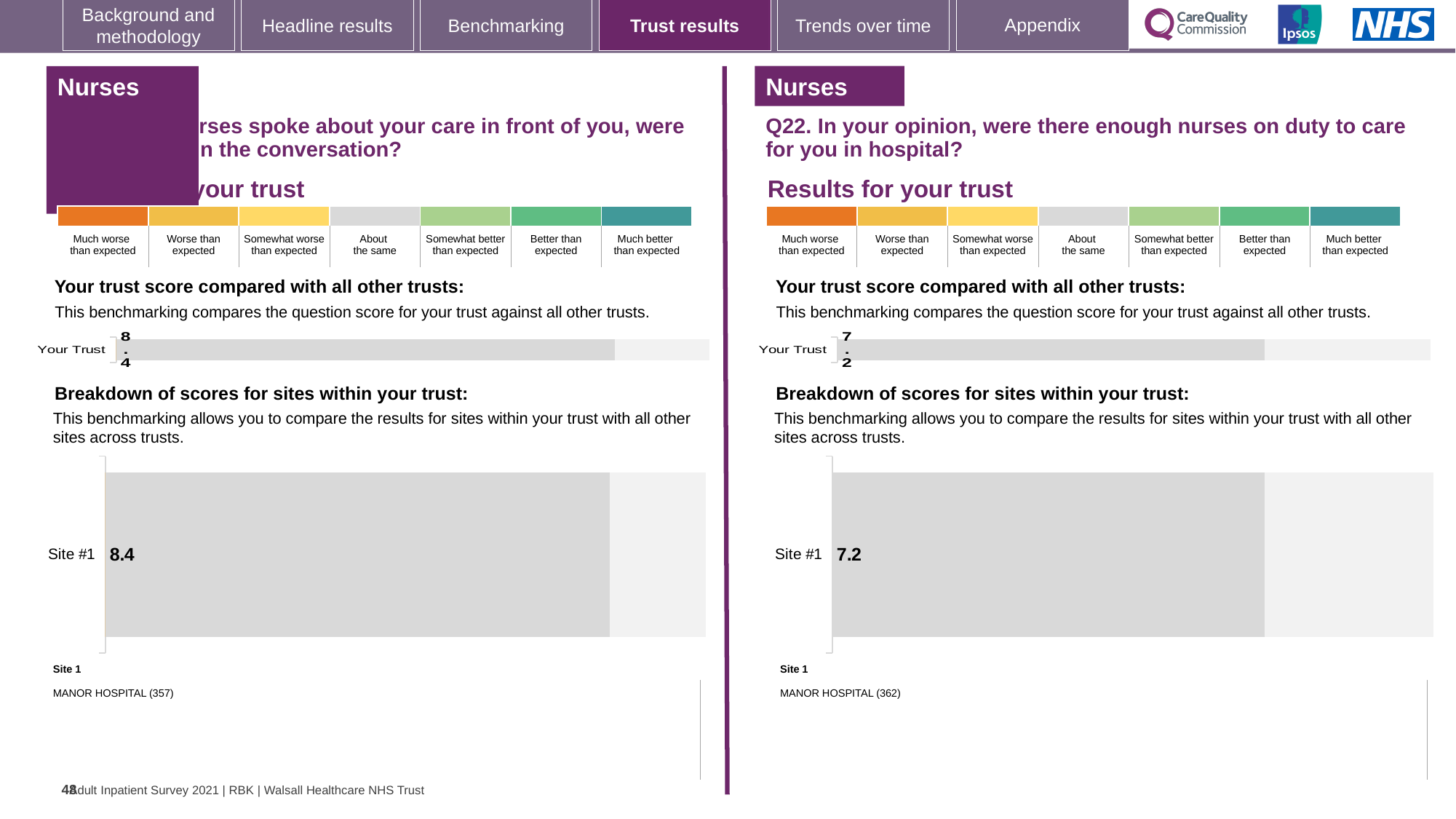
What is the difference between the Site #1 score on the left half of the slide and the Site #1 score on the right half (Q22)? 1.2 How many sites are shown in the site breakdown chart on the right half of the slide (Q22)? 1 What type of chart is used to show the Your Trust score on the left half of the slide? Bar chart How many sites are shown in the site breakdown chart on the left half of the slide? 1 On the left half of the slide, what is the score shown for Your Trust in the trust score chart? 8.4 What type of chart is used for the site breakdown on the right half of the slide (Q22)? Bar chart Which site name is listed as Site 1 below the site breakdown chart on the right half of the slide (Q22)? MANOR HOSPITAL (362) On the right half of the slide (Q22), what is the score shown for Your Trust in the trust score chart? 7.2 Which is larger: the Your Trust score on the left half of the slide or the Your Trust score on the right half (Q22)? Left half (8.4) In the site breakdown chart on the left half of the slide, what is the value for Site #1? 8.4 Which site name is listed as Site 1 below the site breakdown chart on the left half of the slide? MANOR HOSPITAL (357) In the site breakdown chart on the right half of the slide (Q22), what is the value for Site #1? 7.2